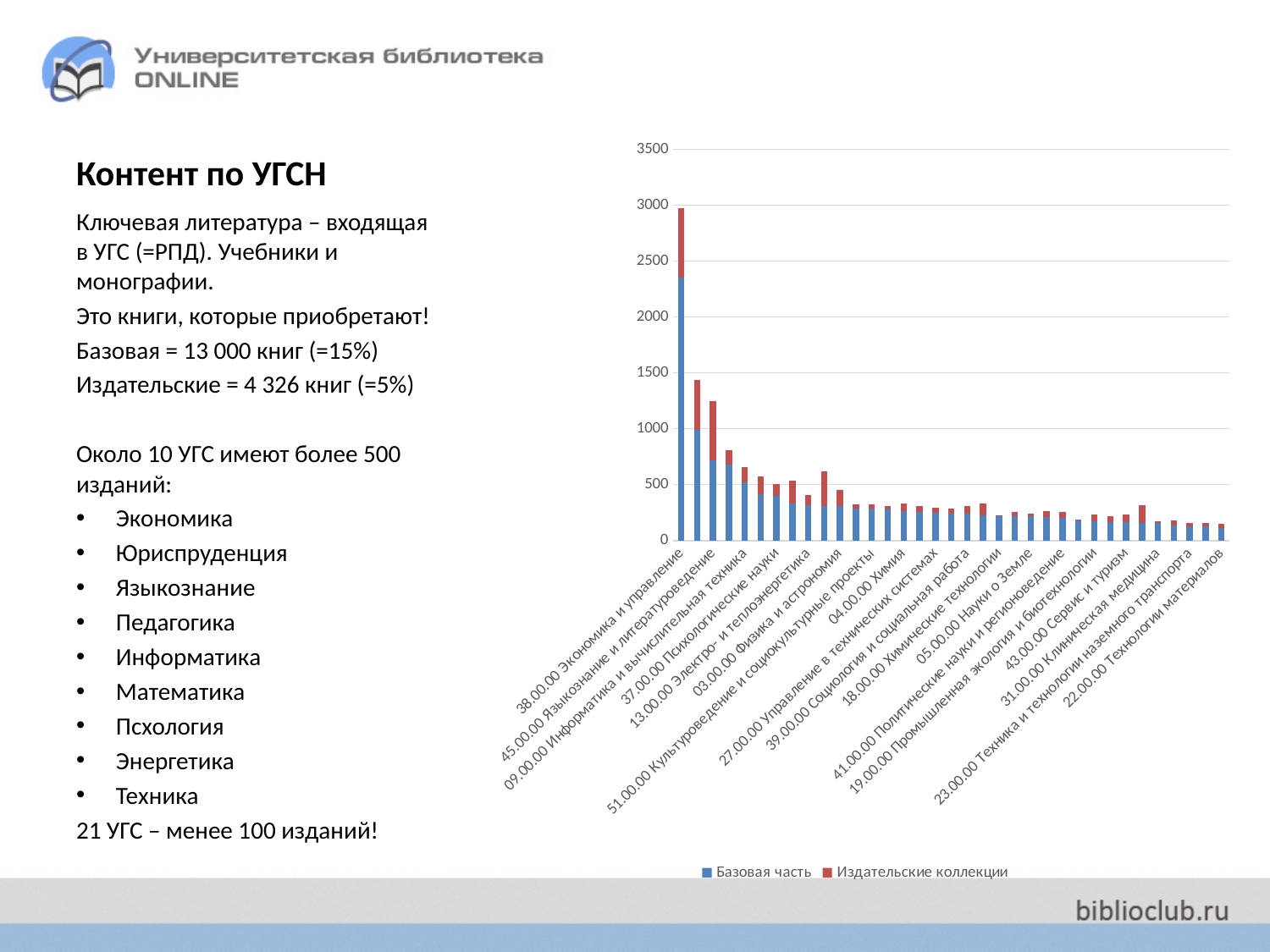
What are the two series named in the chart legend? Базовая часть and Издательские коллекции Do the bar totals generally rise or fall from left to right along the x axis? fall Is the total value for 38.00.00 Экономика и управление greater or less than 2500? greater Is the total value for 09.00.00 Информатика и вычислительная техника greater or less than 1000? less Is the total value for 45.00.00 Языкознание и литературоведение greater or less than 1000? greater Which colour represents the series 'Базовая часть' in the chart? blue Which has a larger total bar: 45.00.00 Языкознание и литературоведение or 04.00.00 Химия? 45.00.00 Языкознание и литературоведение How many series does the chart legend list? 2 Which category has the highest total bar in the chart? 38.00.00 Экономика и управление What kind of chart is shown on the slide? stacked bar chart